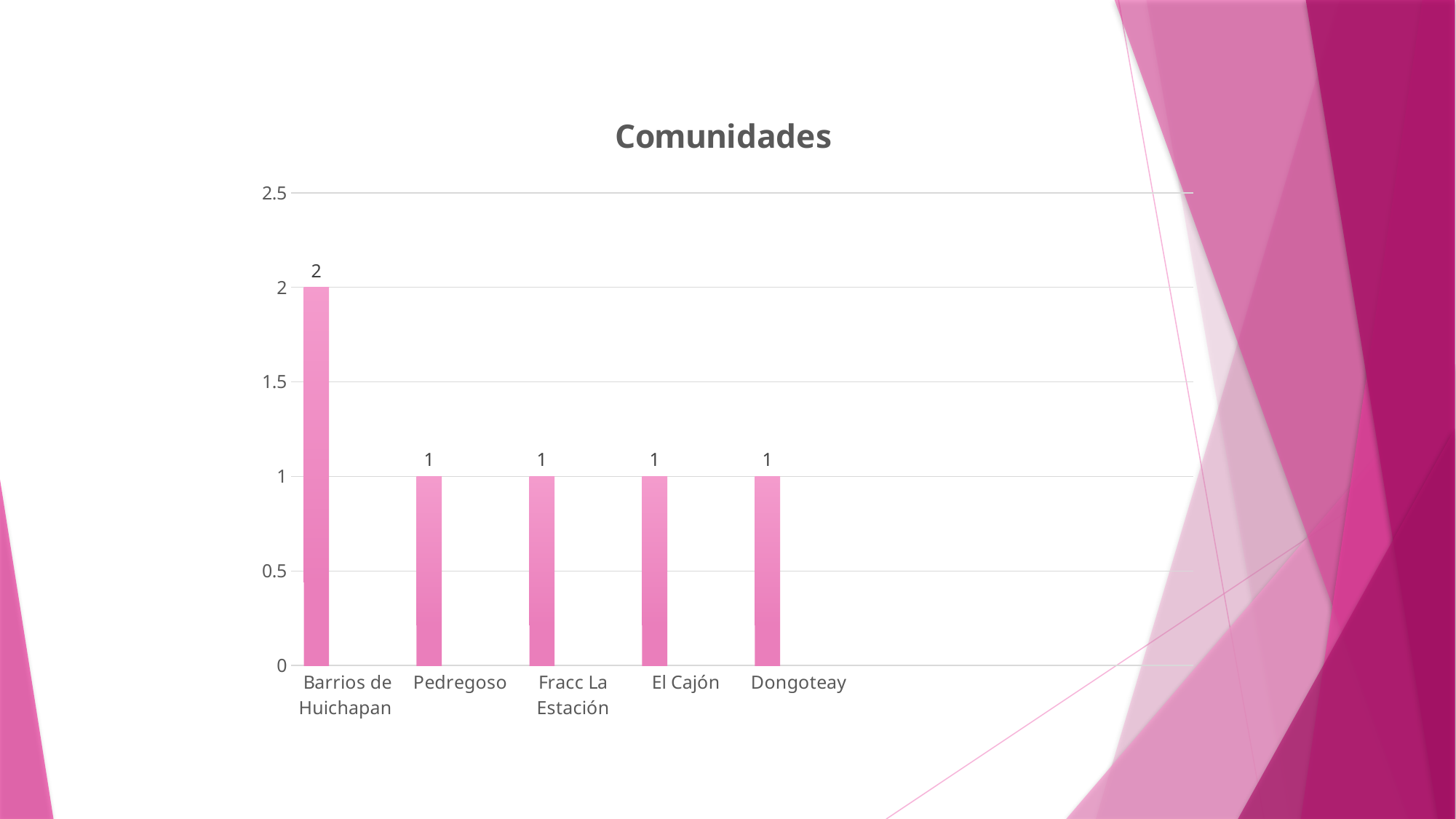
What is the highest value shown on the y axis? 2.5 What is the difference between the values for Barrios de Huichapan and El Cajón? 1 What is the value for Fracc La Estación? 1 How many categories are shown on the x axis? 5 What is the title of the chart? Comunidades What is the value for Barrios de Huichapan? 2 Which is larger, the value for Barrios de Huichapan or the value for Pedregoso? Barrios de Huichapan What is the value for Dongoteay? 1 What is the value for Pedregoso? 1 Which category has the highest value? Barrios de Huichapan What kind of chart is shown on the slide? bar chart Is the value for Barrios de Huichapan greater or less than 1.5? greater